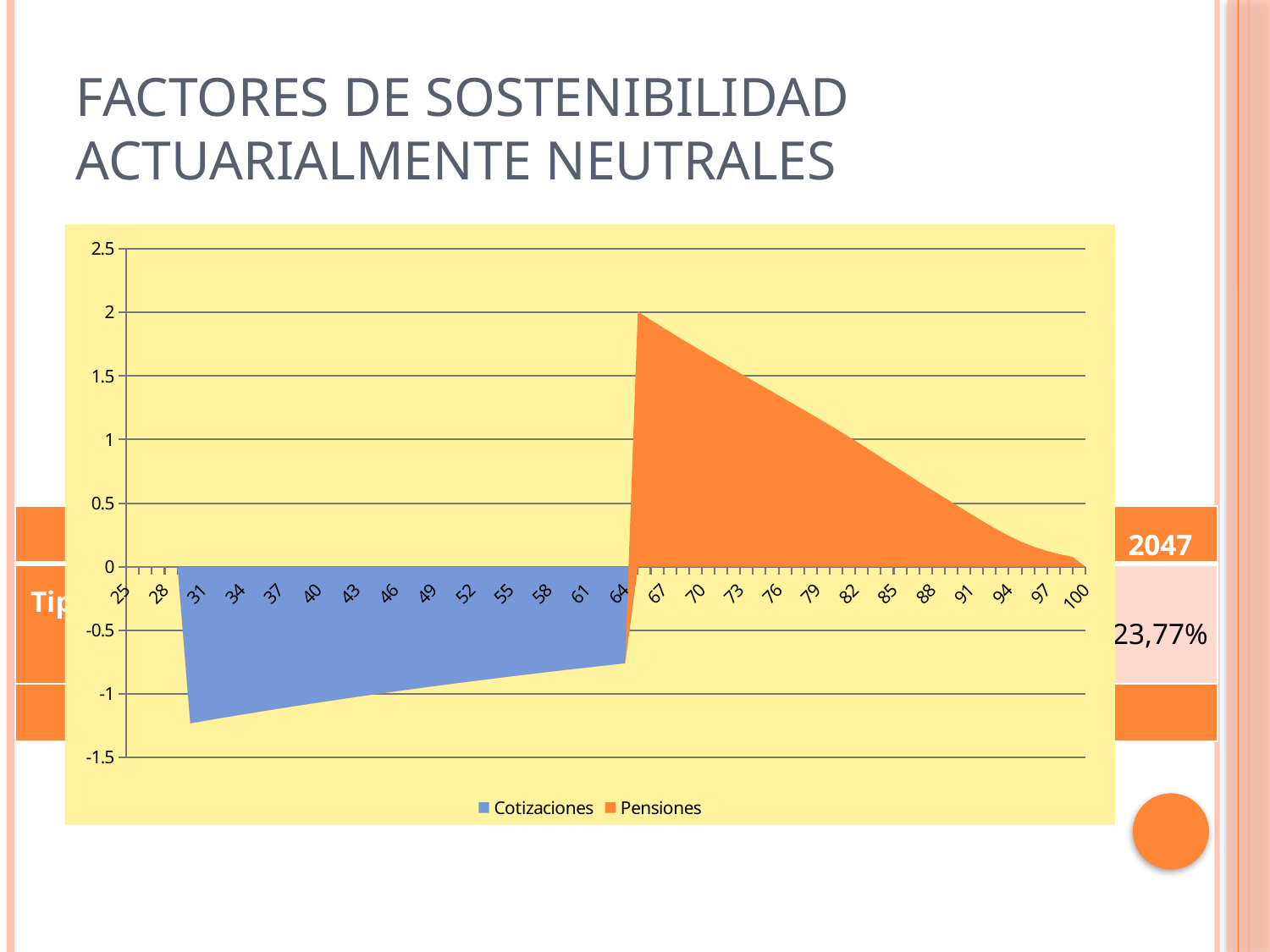
Is the value of Cotizaciones at age 61 greater or less than -1? greater Is the value of Pensiones at age 94 greater or less than 0.5? less Does the Pensiones series rise or fall as age increases from 67 to 100? Fall Is the value of Pensiones at age 85 greater or less than 1? less How many series does the chart legend list? 2 Which series has positive values, Cotizaciones or Pensiones? Pensiones What are the two series named in the chart legend? Cotizaciones and Pensiones How many age labels are shown on the x axis? 26 What kind of chart is shown on the slide? Area chart Which colour represents the Cotizaciones series? Blue